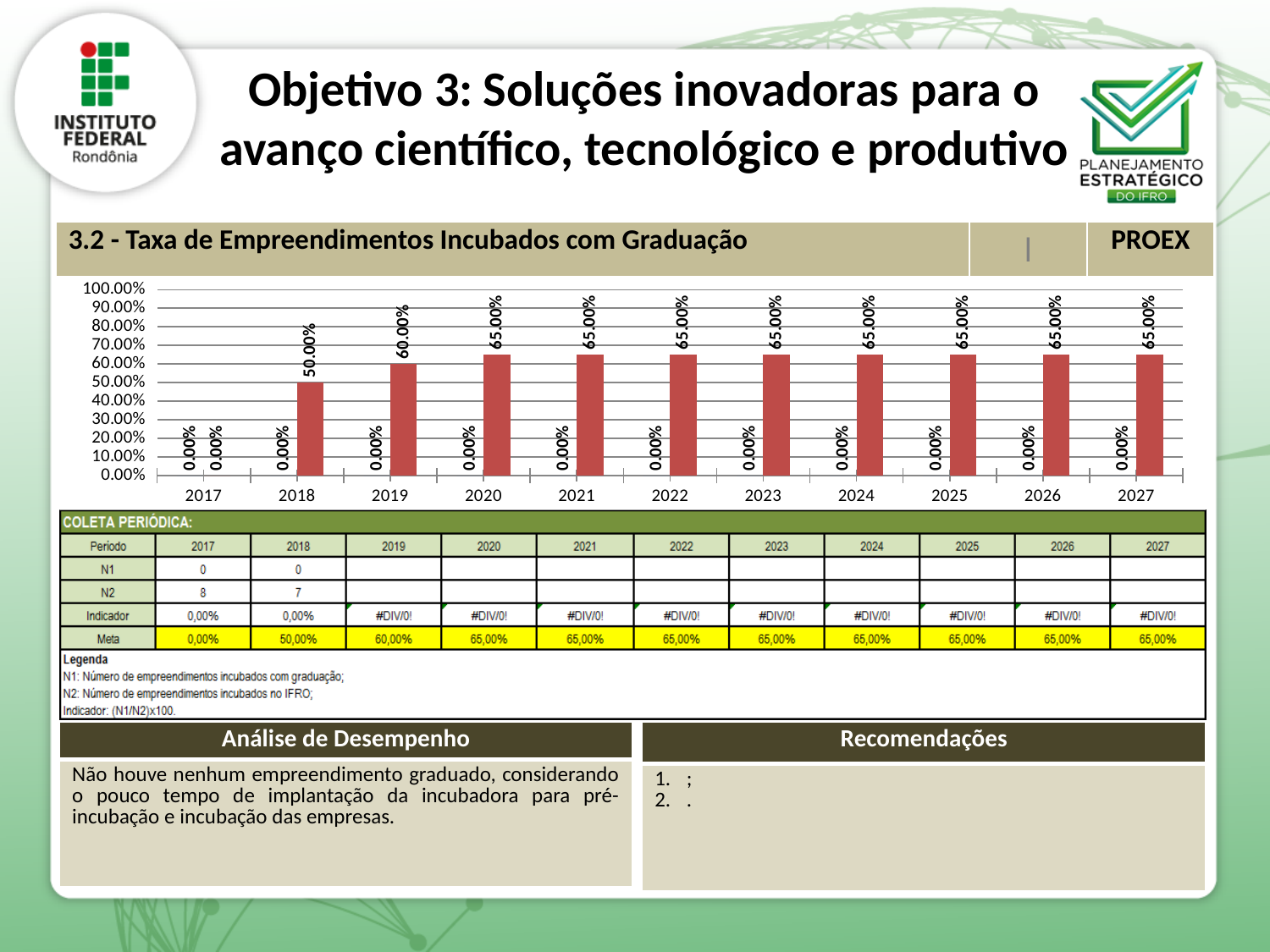
What type of chart is shown on the slide? bar chart Which is larger, the taller bar for 2019 or the taller bar for 2020? 2020 How many years are shown on the x axis of the chart? 11 What is the title of the indicator shown above the chart? 3.2 - Taxa de Empreendimentos Incubados com Graduação What is the value of the taller bar for 2027? 65.00% Which year has the lowest value for the taller bar series? 2017 Do the taller bar values rise or fall from 2017 to 2020? rise What is the value of the taller bar for 2018? 50.00% What is the value labelled for the first bar of 2017? 0.00% What is the value of the taller bar for 2020? 65.00% What is the value of the taller bar for 2019? 60.00% What is the difference between the taller bar values for 2019 and 2018? 10.00%